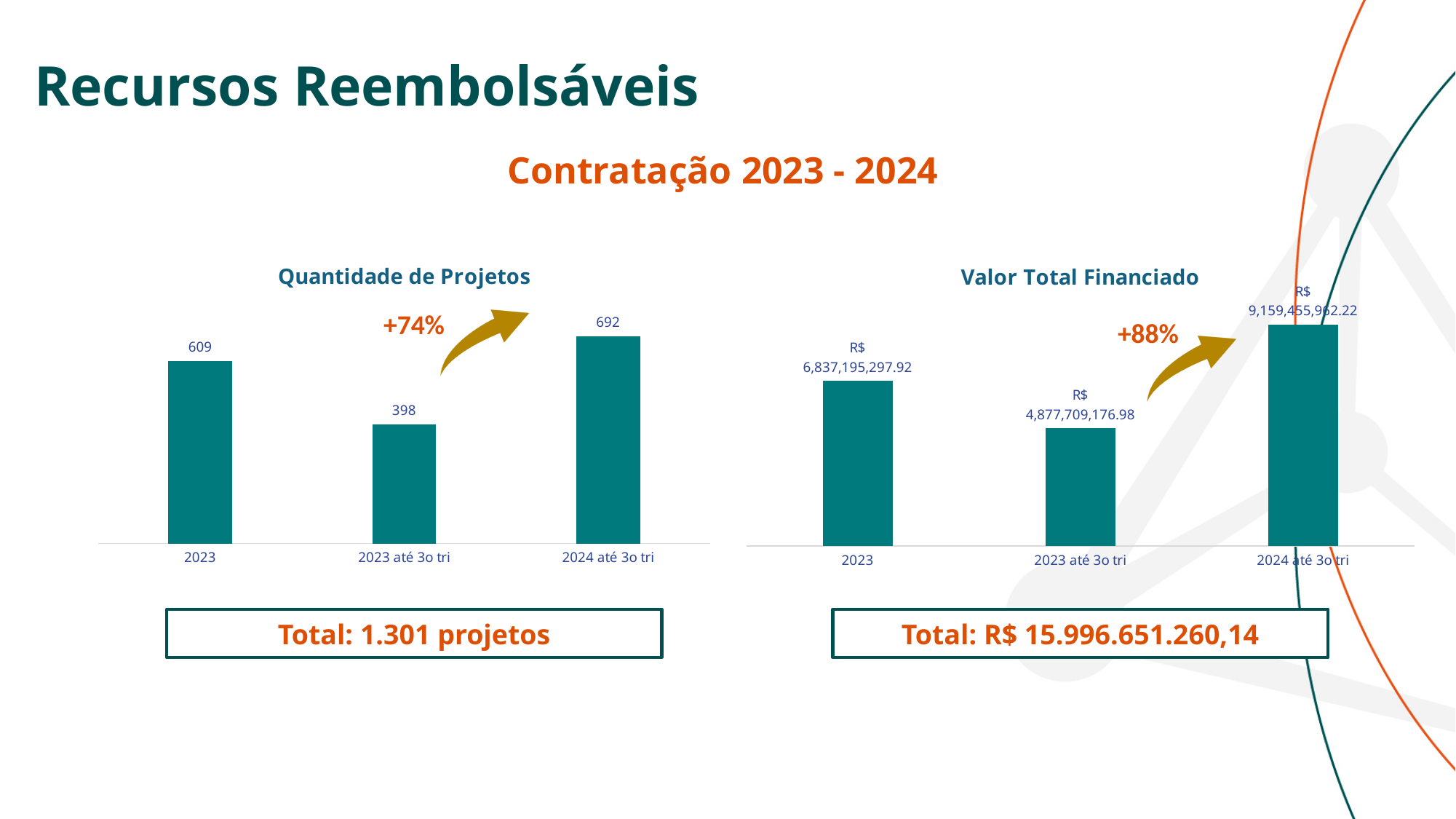
In the 'Quantidade de Projetos' chart, what is the value for '2023 até 3o tri'? 398 In the 'Valor Total Financiado' chart, what is the value for '2023 até 3o tri'? R$ 4,877,709,176.98 In the 'Quantidade de Projetos' chart, what is the difference between the values for '2024 até 3o tri' and '2023 até 3o tri'? 294 In the 'Valor Total Financiado' chart, which category has the highest value? 2024 até 3o tri In the 'Quantidade de Projetos' chart, which category has the highest value? 2024 até 3o tri In the 'Valor Total Financiado' chart, which is larger: the value for 2023 or the value for '2023 até 3o tri'? 2023 In the 'Quantidade de Projetos' chart, what is the value for '2024 até 3o tri'? 692 In the 'Valor Total Financiado' chart, what is the value for 2023? R$ 6,837,195,297.92 In the 'Quantidade de Projetos' chart, what is the value for 2023? 609 How many categories are shown in the 'Quantidade de Projetos' chart? 3 In the 'Quantidade de Projetos' chart, which category has the lowest value? 2023 até 3o tri In the 'Quantidade de Projetos' chart, what is the difference between the values for 2023 and '2023 até 3o tri'? 211